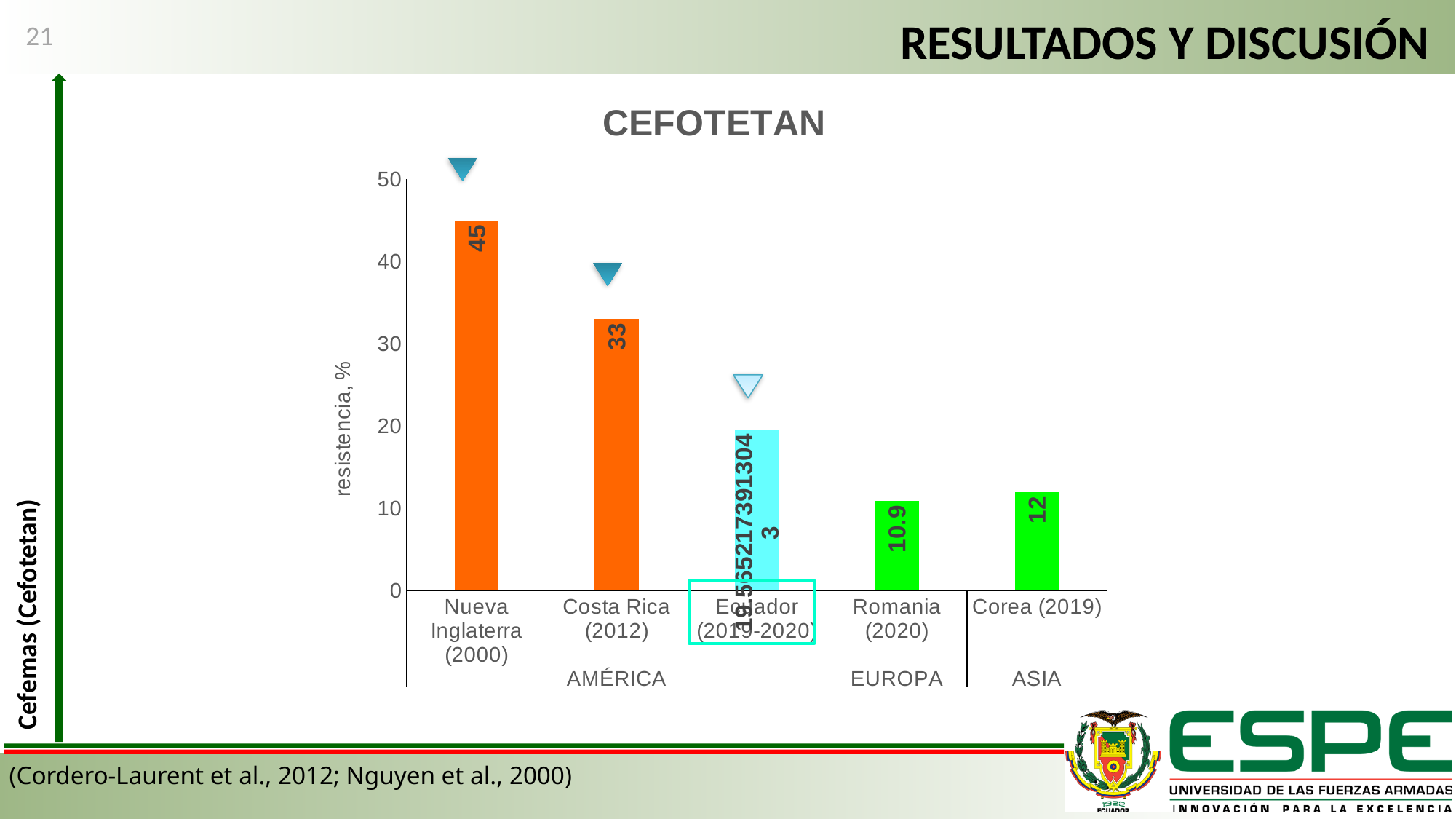
Which category has the highest resistance value? Nueva Inglaterra (2000) How many categories are shown on the x axis? 5 Is the value for Ecuador (2019-2020) greater or less than 30? less What is the chart's title? CEFOTETAN What is the resistance value for Corea (2019)? 12 What is the resistance value for Costa Rica (2012)? 33 Which category has the lowest resistance value? Romania (2020) What type of chart is shown on the slide? bar chart What is the difference between the values for Nueva Inglaterra (2000) and Costa Rica (2012)? 12 What is the resistance value for Romania (2020)? 10.9 Which is larger, the value for Corea (2019) or the value for Romania (2020)? Corea (2019) What is the resistance value for Nueva Inglaterra (2000)? 45